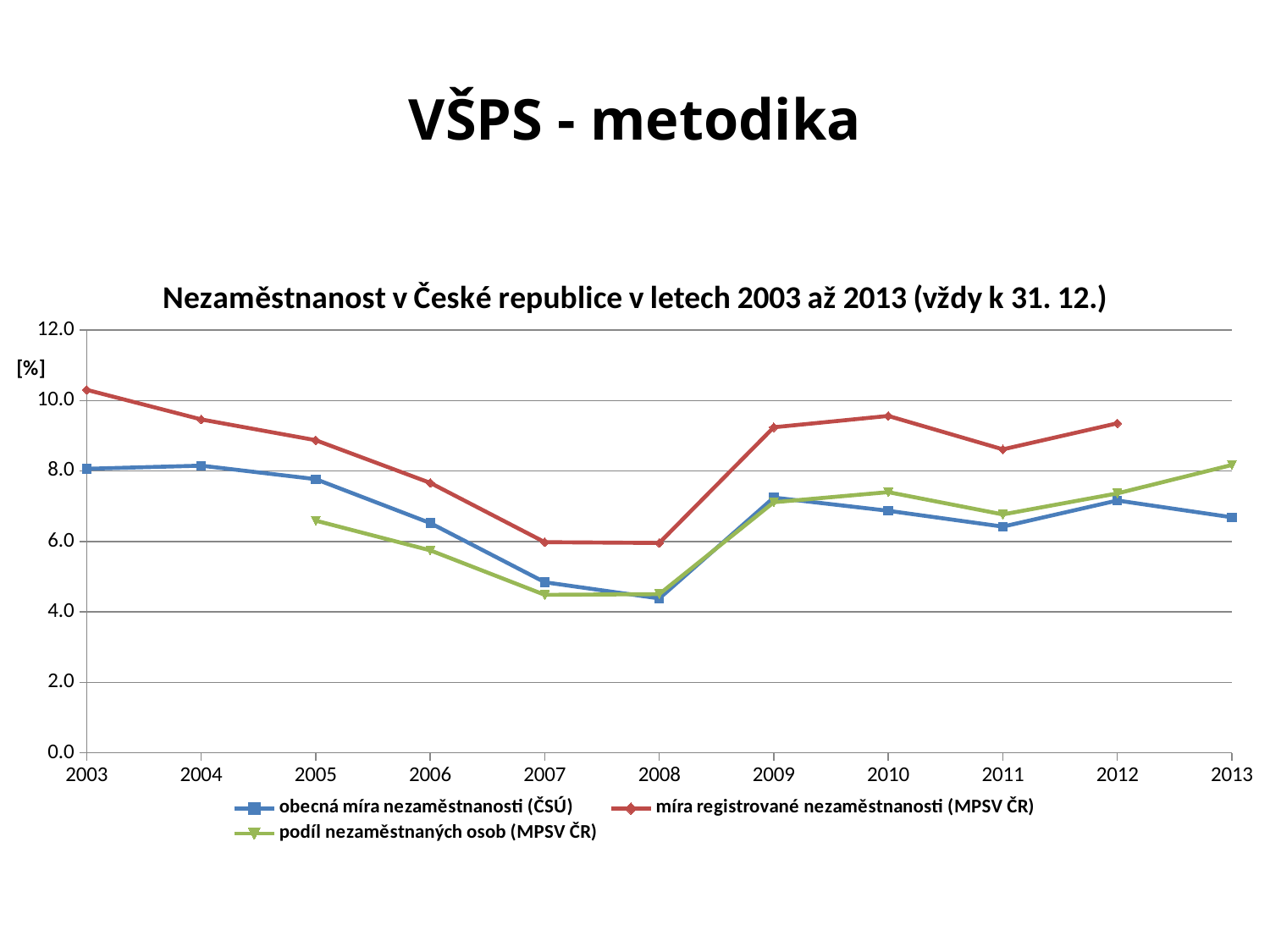
In which year is the podíl nezaměstnaných osob (MPSV ČR) series highest? 2013 Is the value for míra registrované nezaměstnanosti (MPSV ČR) in 2003 greater or less than 8.0? greater In 2003, which is larger: obecná míra nezaměstnanosti (ČSÚ) or míra registrované nezaměstnanosti (MPSV ČR)? míra registrované nezaměstnanosti (MPSV ČR) What kind of chart is shown on the slide? line chart In which year is the míra registrované nezaměstnanosti (MPSV ČR) series highest? 2003 Which series starts only in 2005 rather than 2003? podíl nezaměstnaných osob (MPSV ČR) How many years are shown on the x axis? 11 What is the title of the chart? Nezaměstnanost v České republice v letech 2003 až 2013 (vždy k 31. 12.) Is the value for obecná míra nezaměstnanosti (ČSÚ) in 2008 greater or less than 6.0? less How many series does the legend list? 3 In which year is the obecná míra nezaměstnanosti (ČSÚ) series lowest? 2008 Does the míra registrované nezaměstnanosti (MPSV ČR) series rise or fall from 2003 to 2007? fall